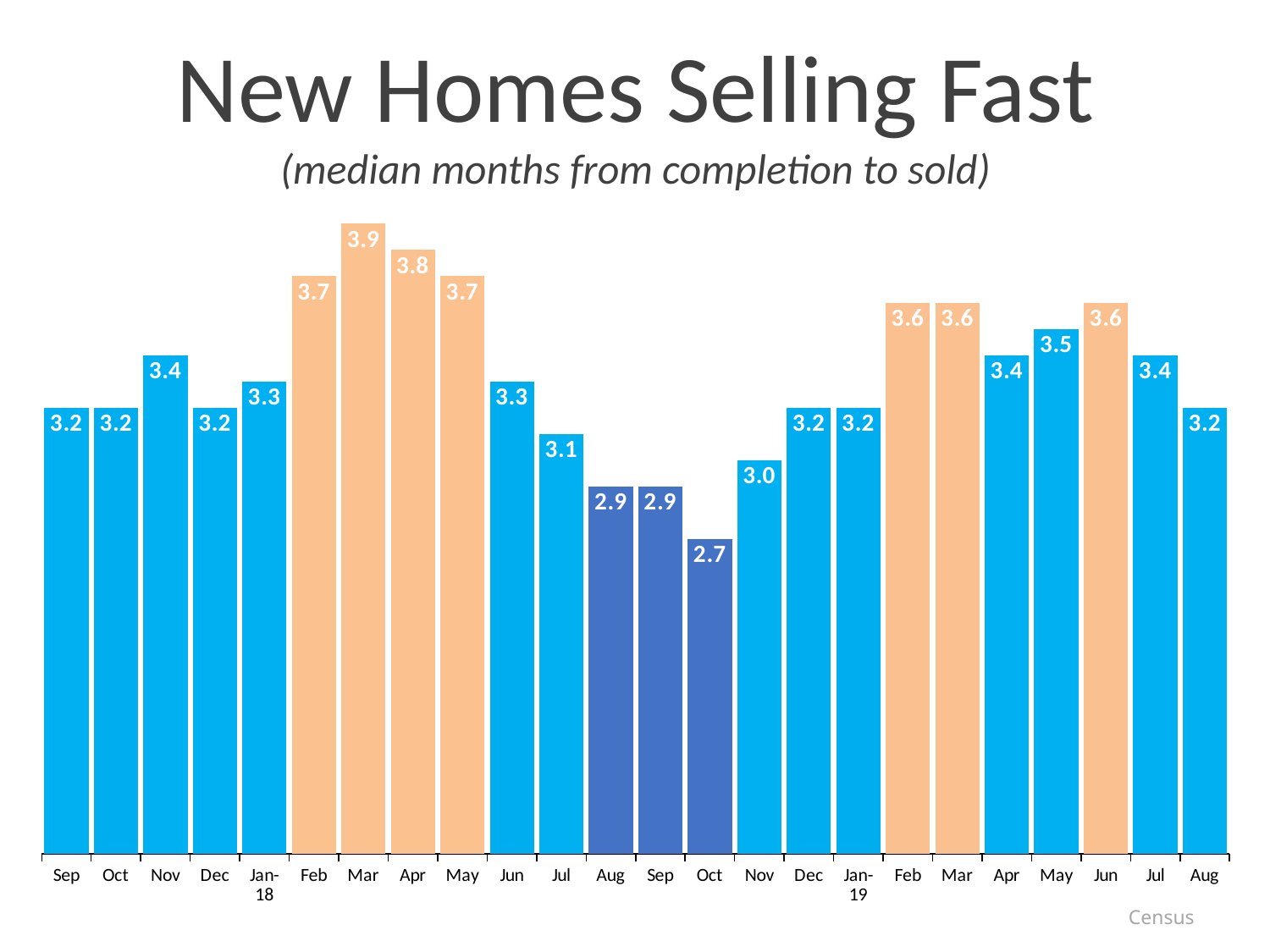
Which month has the highest value? Mar (2018) What is the value for the May bar in 2019 (between Apr and Jun after Jan-19)? 3.5 Which month has the lowest value? Oct (2018) Which is larger, the value for Apr 2018 or the value for Apr 2019? Apr 2018 What is the difference between the highest value (Mar 2018) and the lowest value (Oct 2018)? 1.2 What is the value for the Oct bar between Sep and Nov in 2018 (the darkest bar)? 2.7 What is the subtitle of the chart? (median months from completion to sold) What is the value for Jan-18? 3.3 What is the value for Jan-19? 3.2 Do the values rise or fall from Jun 2018 to Oct 2018? Fall What type of chart is shown? Bar chart How many bars are shown in the chart? 24